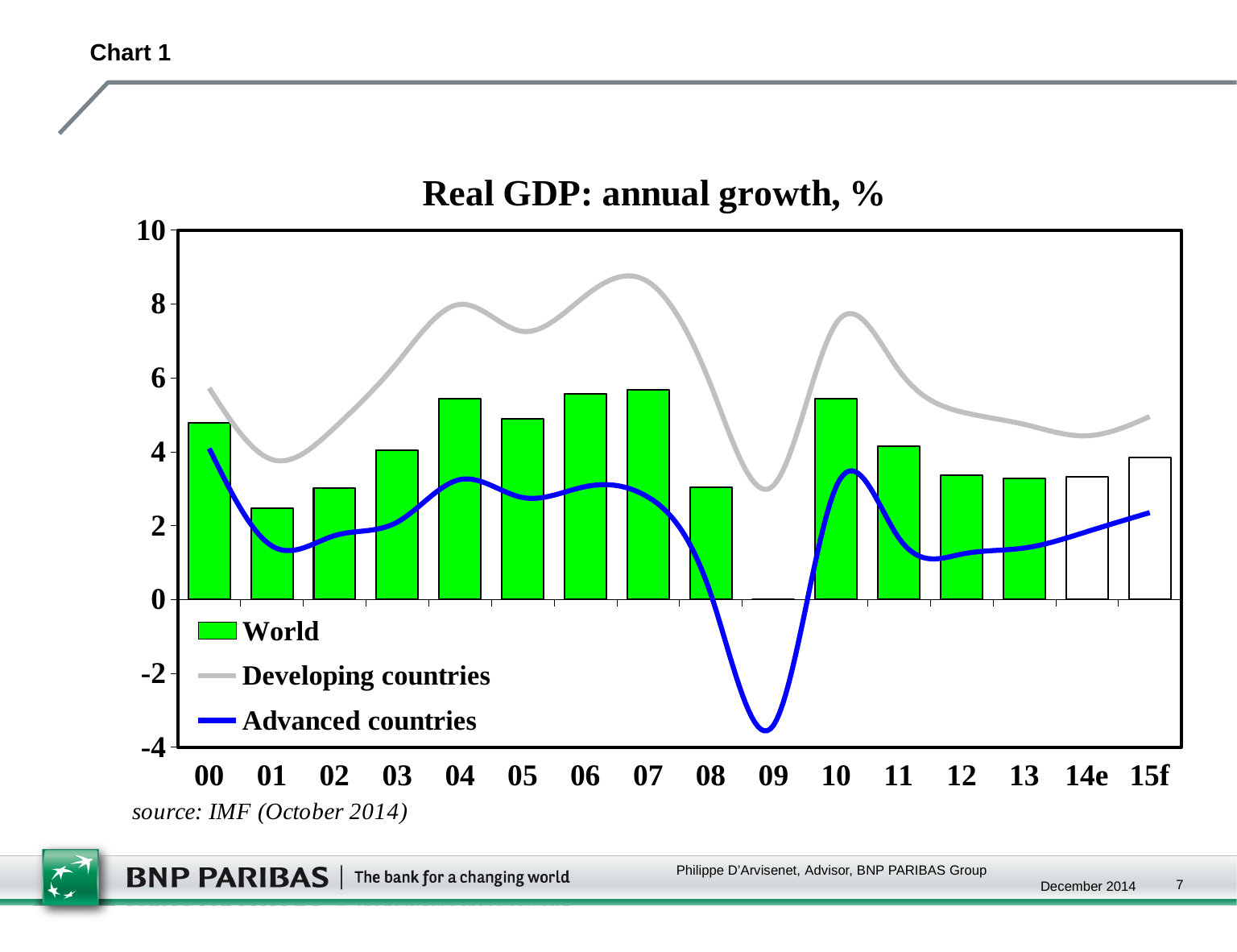
In which year does the Developing countries line reach its highest point? 07 Which series is plotted as bars? World How many series does the legend list? 3 Is the Developing countries value for 09 greater or less than 4? less Which is larger, the World value for 00 or for 01? 00 What is the title of the chart? Real GDP: annual growth, % In which year does the Advanced countries line reach its lowest point? 09 Is the Advanced countries value for 09 greater or less than -2? less What kind of chart is shown on the slide? A combined bar and line chart How many years are shown along the x axis? 16 In which year is the World bar lowest? 09 Is the World value for 01 greater or less than 2? greater